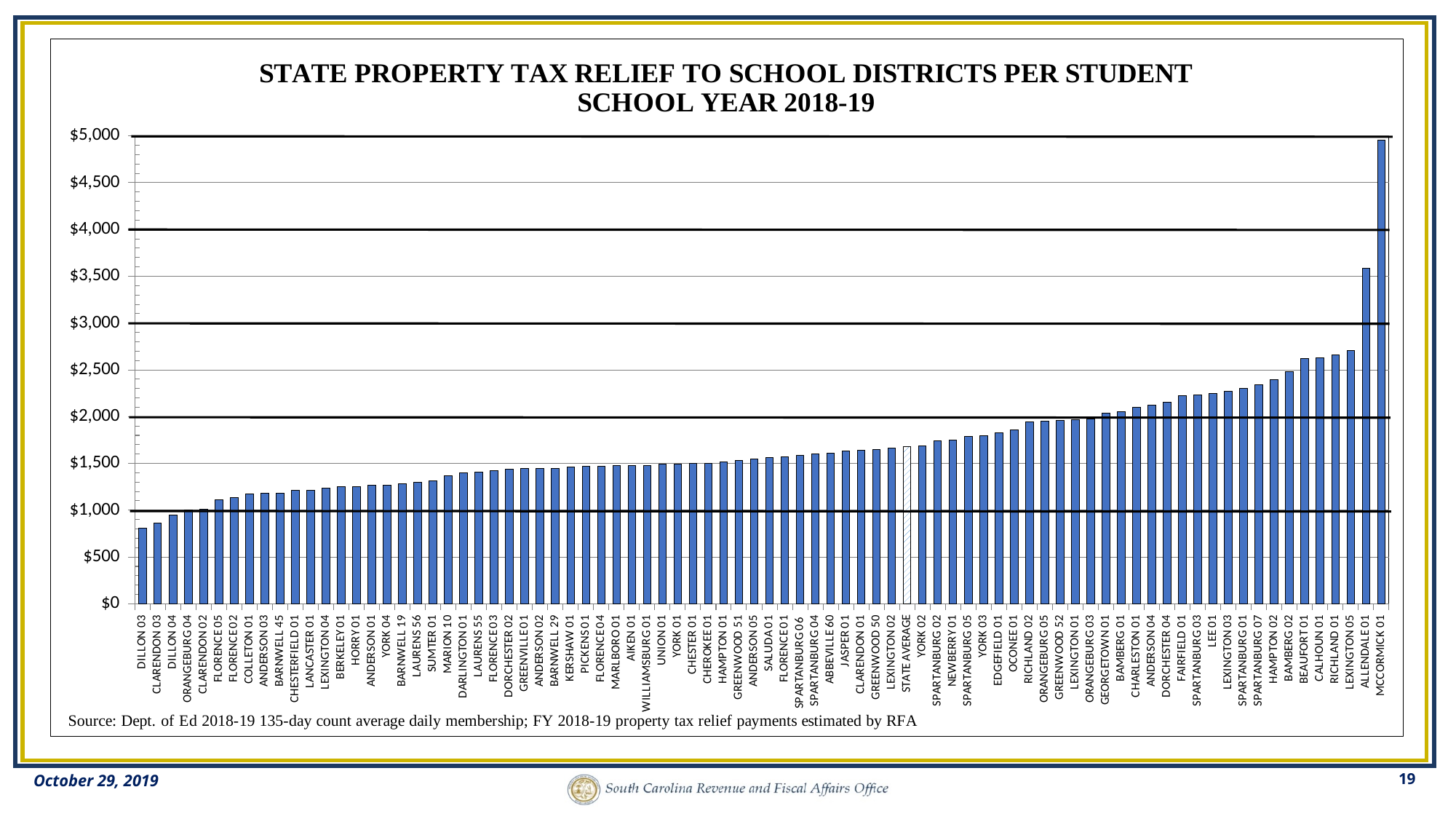
Which district has the lowest state property tax relief per student? DILLON 03 Is the value for BEAUFORT 01 greater or less than $2,500? greater What school year does the chart title refer to? 2018-19 What kind of chart is shown on the slide? bar chart Is the value for ALLENDALE 01 greater or less than $3,000? greater Which has the larger value, HORRY 01 or BEAUFORT 01? BEAUFORT 01 Do the values generally rise or fall moving from left to right along the x axis? rise Is the value for DILLON 03 greater or less than $1,000? less Which district has the highest state property tax relief per student? MCCORMICK 01